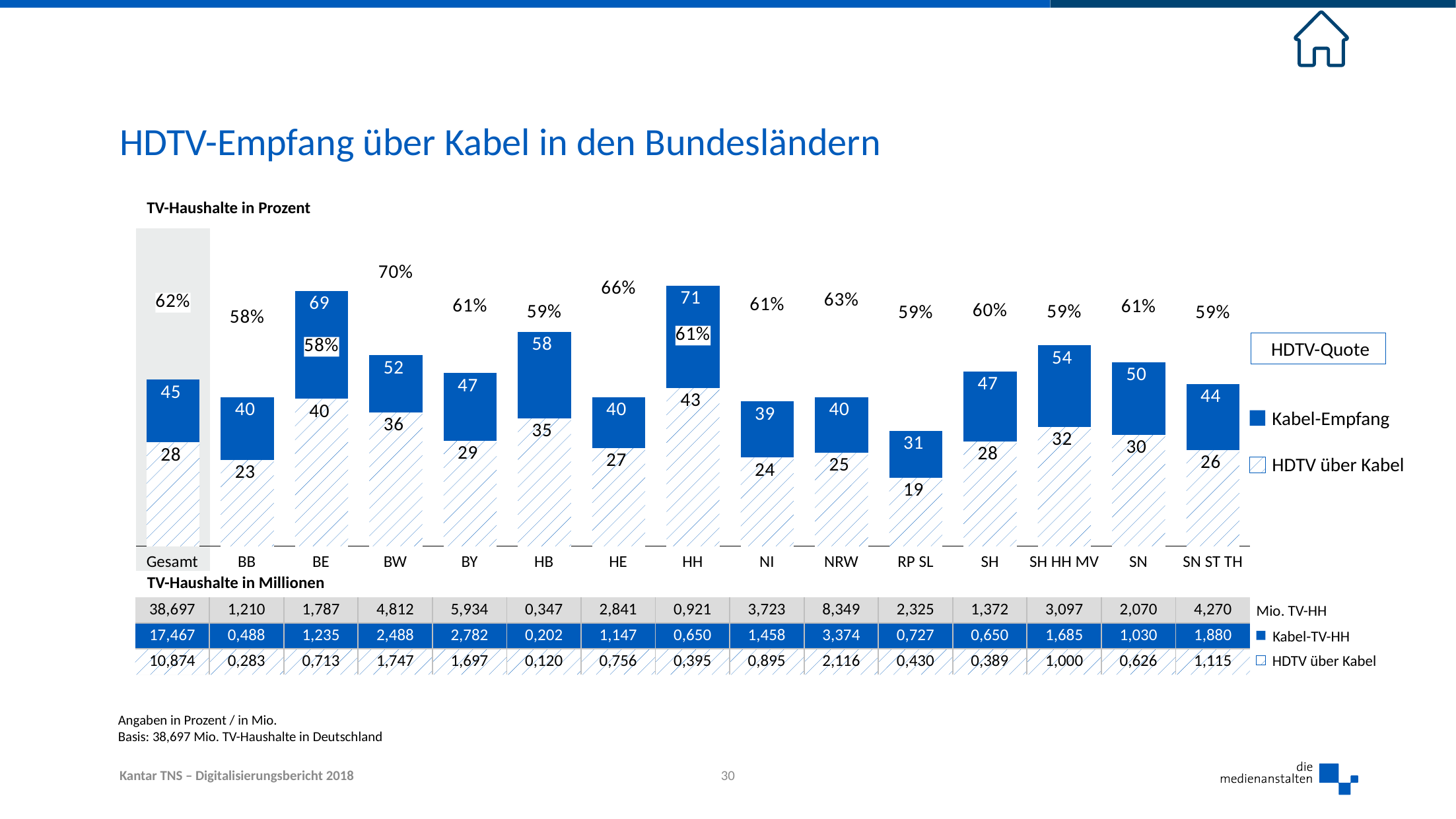
Which Bundesland has the highest Kabel-Empfang value? HH How many series does the legend list? 3 What is the HDTV-Quote shown for BW? 70% What kind of chart is shown on the slide? bar chart In the table below the chart, what is the Kabel-TV-HH value for NRW? 3,374 What is the difference between the Kabel-Empfang value and the HDTV über Kabel value for BE? 29 Which is larger, the Kabel-Empfang value for BW or for SN? BW Which category has the lowest HDTV über Kabel value? RP SL What is the Kabel-Empfang value for HH? 71 What is the HDTV über Kabel value for BW? 36 What is the HDTV-Quote for Gesamt? 62% How many categories are shown on the x axis of the chart? 15